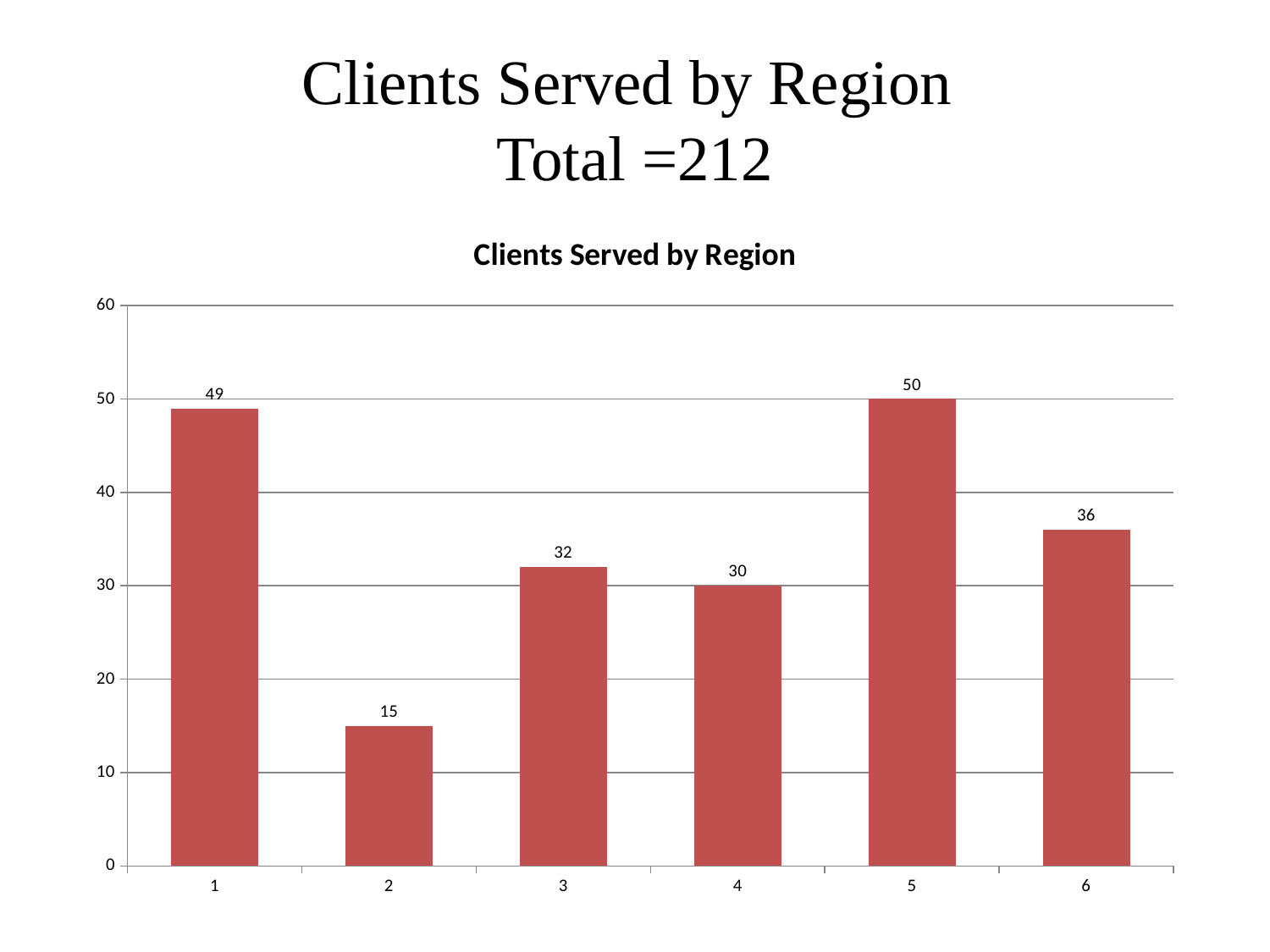
What is the value for region 4? 30 What is the value for region 1? 49 What is the difference between the values for region 5 and region 2? 35 What is the value for region 6? 36 What is the value for region 2? 15 Which is larger, the value for region 3 or region 6? Region 6 What is the title of the chart? Clients Served by Region Which region has the highest value? 5 Is the value for region 3 greater or less than 40? less How many regions are shown on the chart? 6 Which region has the lowest value? 2 What kind of chart is shown? Bar chart